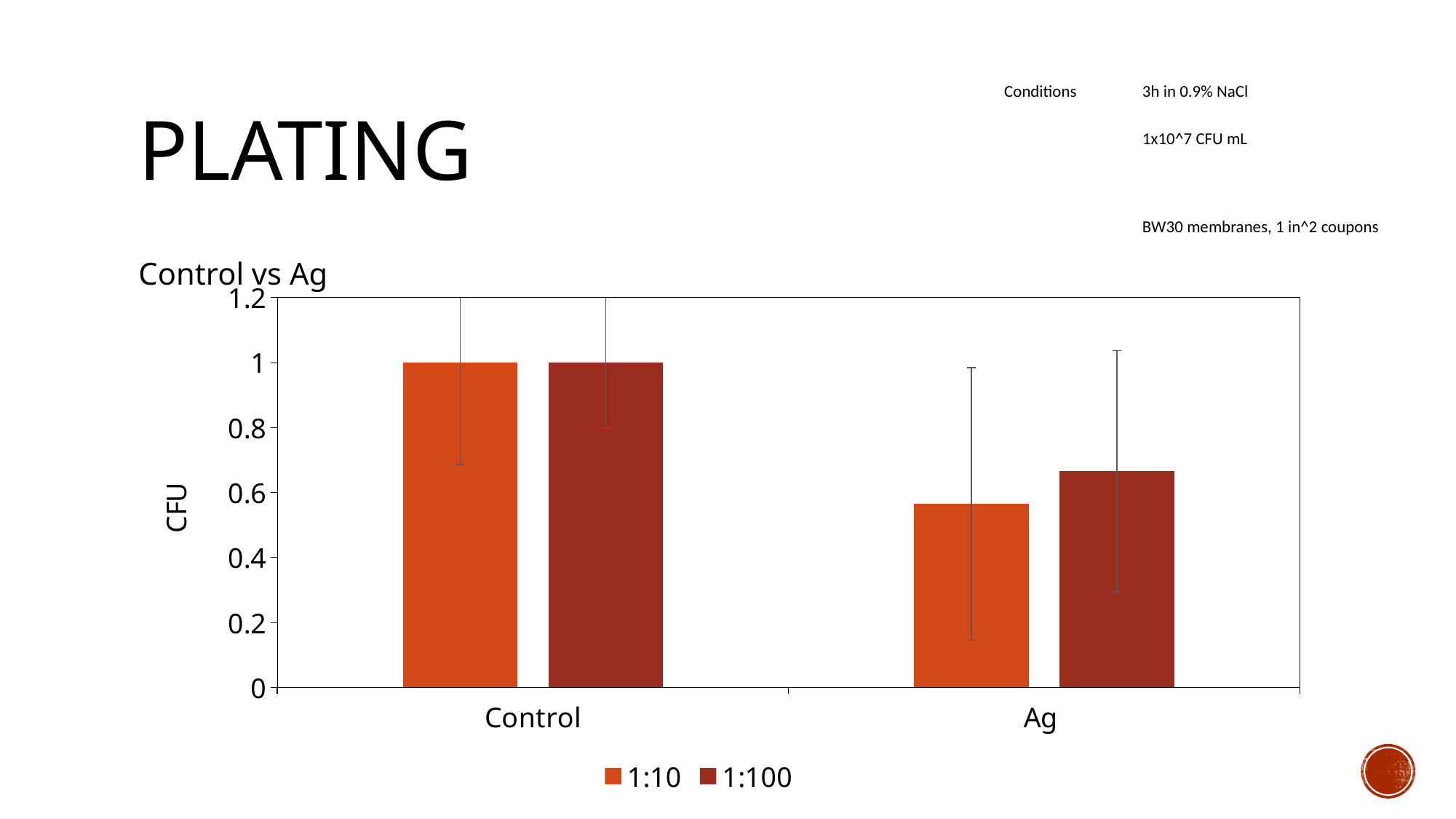
Is the value for the 1:10 series in the Ag category greater or less than 0.6? less What is the value for the 1:10 series in the Control category? 1 What kind of chart is shown on the slide? bar chart What is the label of the y axis? CFU In the Ag category, which series has the larger value, 1:10 or 1:100? 1:100 Is the value for the 1:100 series in the Ag category greater or less than 0.6? greater How many categories are shown on the x axis? 2 Which bar has the lowest value in the chart? 1:10 in Ag What is the value for the 1:100 series in the Control category? 1 Do the values rise or fall from Control to Ag? fall How many series does the legend list? 2 What is the title of the chart? Control vs Ag